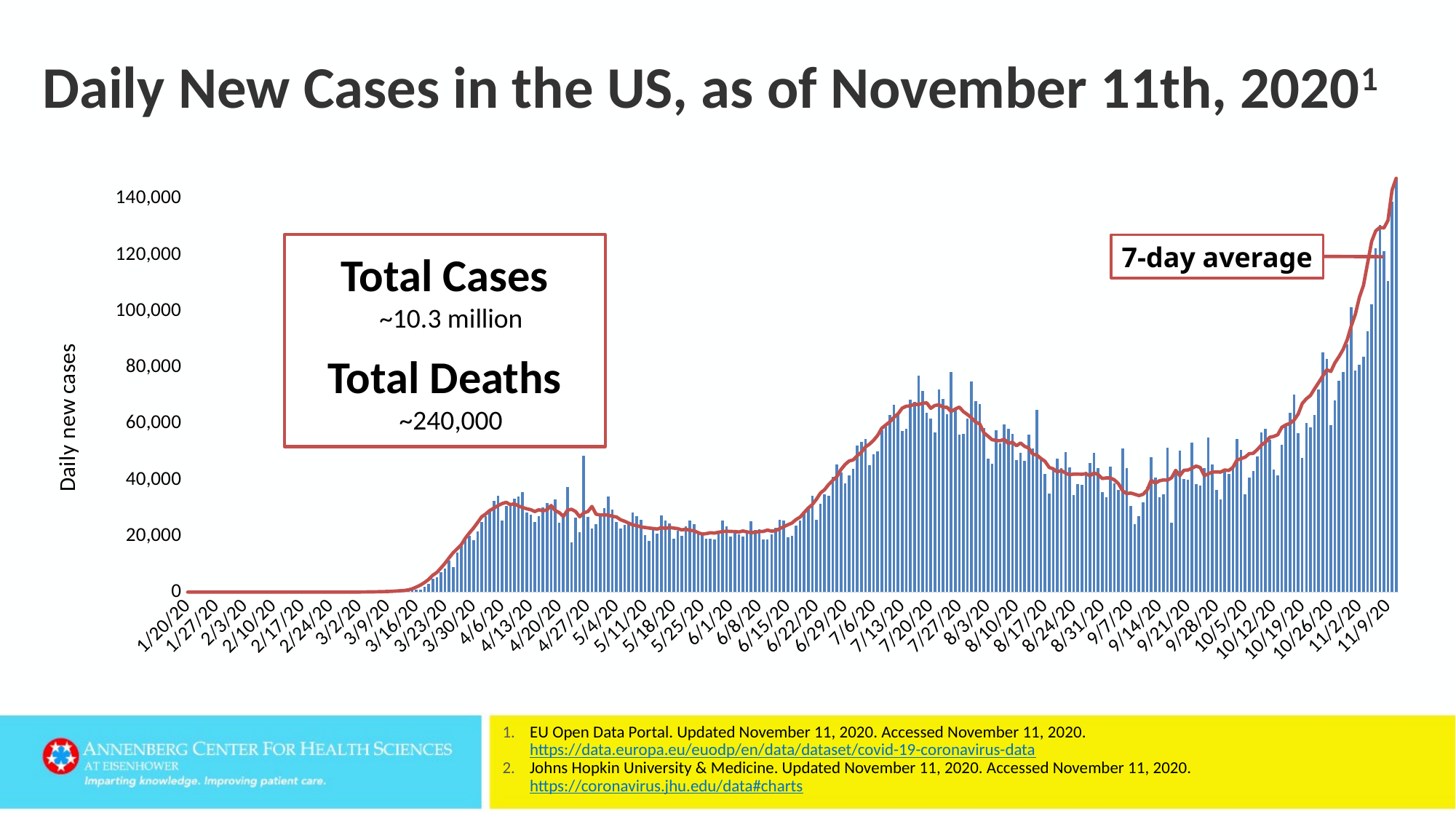
Is the 7-day average of daily new cases around 6/1/20 greater or less than 40,000? less Do daily new cases rise or fall between 10/5/20 and 11/9/20? rise What kind of chart is used to show daily new cases on this slide? bar chart What total number of cases is stated in the box on the chart? ~10.3 million Is the 7-day average of daily new cases around 4/13/20 greater or less than 20,000? greater Is the 7-day average of daily new cases around 11/9/20 greater or less than 120,000? greater Around which date on the x axis do daily new cases reach their highest level? 11/9/20 What does the red line on the chart represent? 7-day average Do daily new cases rise or fall between 7/27/20 and 9/7/20? fall